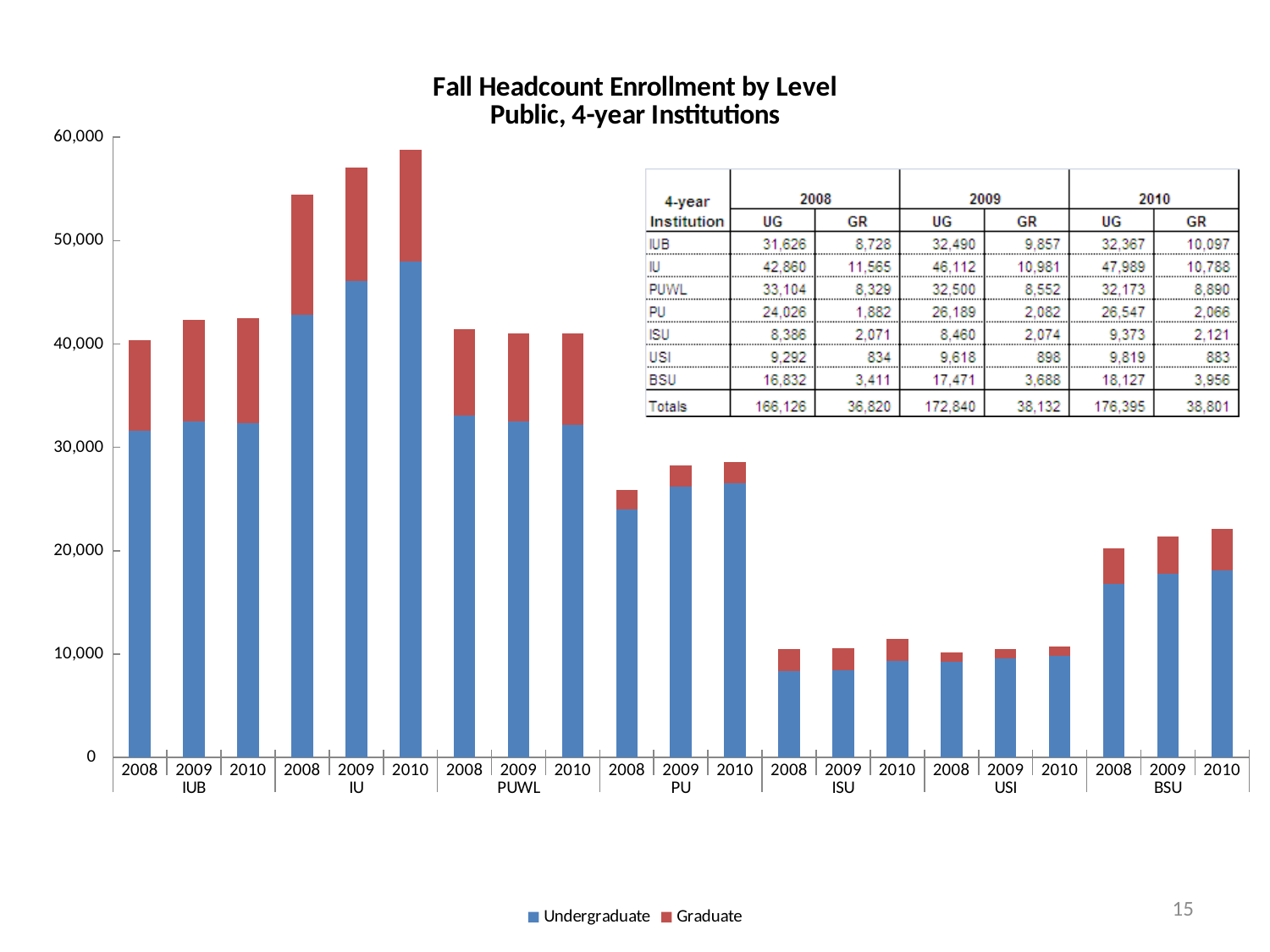
How many institutions are shown along the x axis? 7 According to the table, what was the undergraduate (UG) headcount at IU in 2010? 47,989 Using the table values, how much larger is the IUB undergraduate headcount in 2010 than in 2008? 741 Does the undergraduate headcount at PU rise or fall from 2008 to 2010? rise How many series does the legend list? 2 Which institution and year has the tallest stacked bar? IU 2010 Using the table values, what is the total (UG plus GR) headcount for IUB in 2008? 40,354 According to the table, what was the graduate (GR) headcount at BSU in 2008? 3,411 Which is larger, the 2009 graduate headcount at IUB or at PUWL? IUB Is the total enrollment bar for PU in 2010 greater or less than 30,000? less Is the total enrollment bar for IU in 2008 greater or less than 50,000? greater What kind of chart is shown on the slide? Stacked bar chart